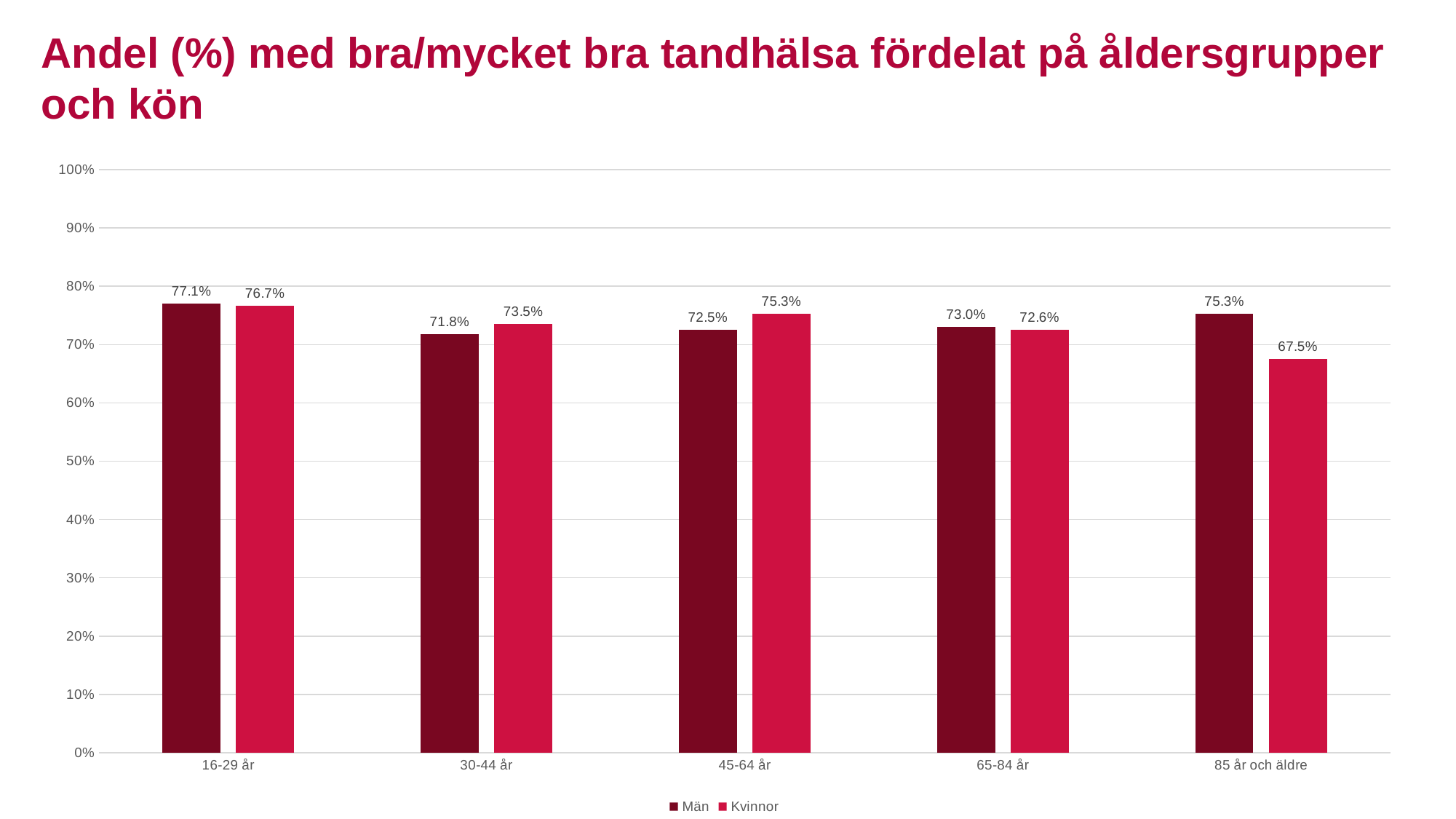
In the 45-64 år age group, which is larger, Män or Kvinnor? Kvinnor How many series does the legend list? 2 Which age group has the lowest value for Kvinnor? 85 år och äldre What is the value for Män in the 16-29 år age group? 77.1% How many age groups are shown on the x axis? 5 Is the value for Kvinnor in the 85 år och äldre age group greater or less than 70%? less What is the value for Kvinnor in the 85 år och äldre age group? 67.5% What kind of chart is shown on the slide? bar chart What is the value for Kvinnor in the 45-64 år age group? 75.3% What are the two series named in the legend? Män and Kvinnor Which age group has the highest value for Män? 16-29 år What is the difference between Män and Kvinnor in the 85 år och äldre age group? 7.8 percentage points